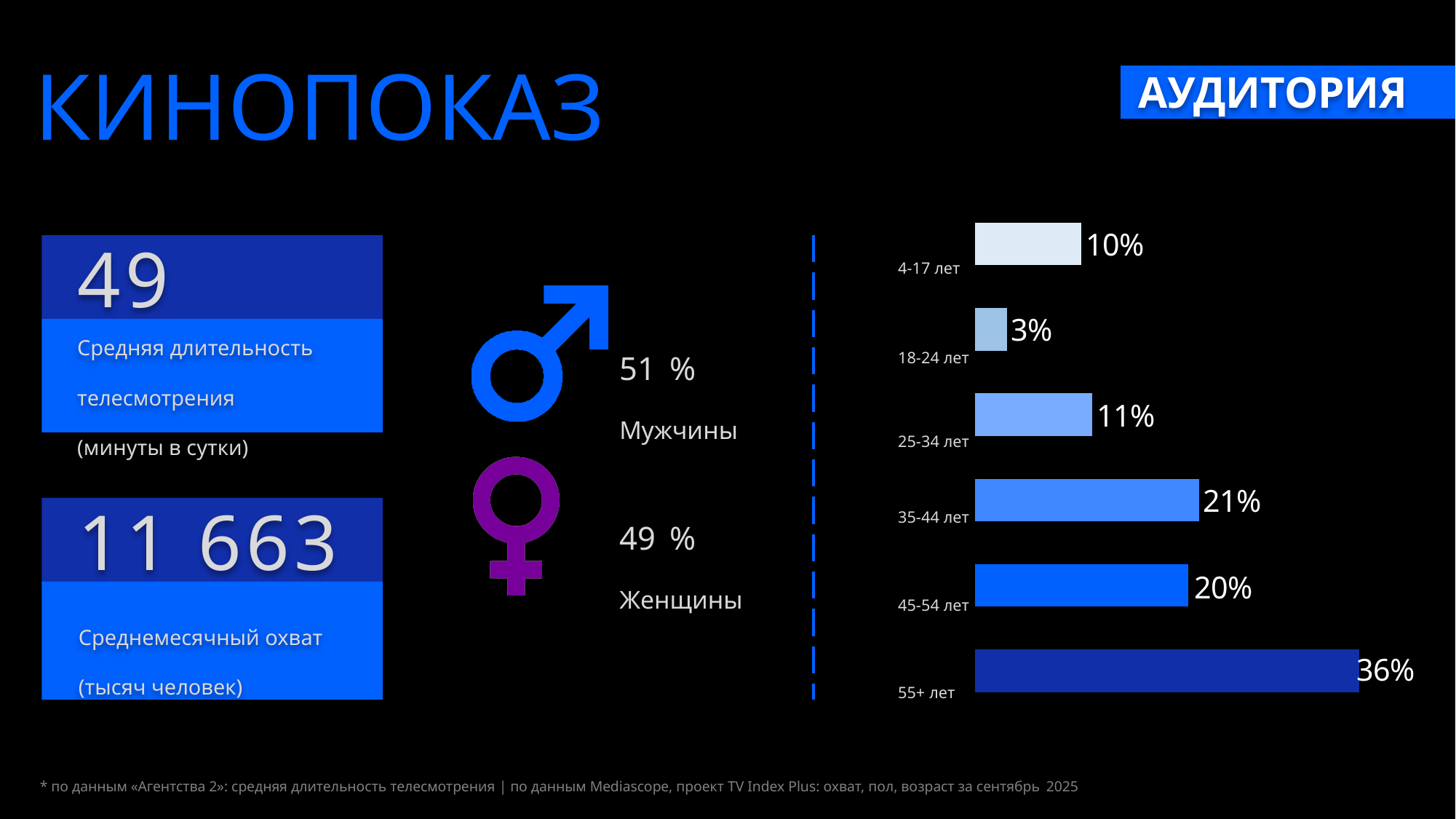
What is the difference between the values for 55+ лет and 35-44 лет in the bar chart? 15% What is the value for the 18-24 лет age group in the bar chart? 3% Which is larger in the bar chart: the value for 45-54 лет or the value for 25-34 лет? 45-54 лет What is the value for the 4-17 лет age group in the bar chart? 10% What is the difference between the values for 25-34 лет and 18-24 лет in the bar chart? 8% How many age groups are shown in the bar chart? 6 What is the value for the 55+ лет age group in the bar chart? 36% Which age group has the lowest value in the bar chart? 18-24 лет What kind of chart is used to show the age groups on the slide? Bar chart What is the value for the 35-44 лет age group in the bar chart? 21% Which age group has the highest value in the bar chart? 55+ лет What is the combined value of the 4-17 лет and 18-24 лет age groups in the bar chart? 13%